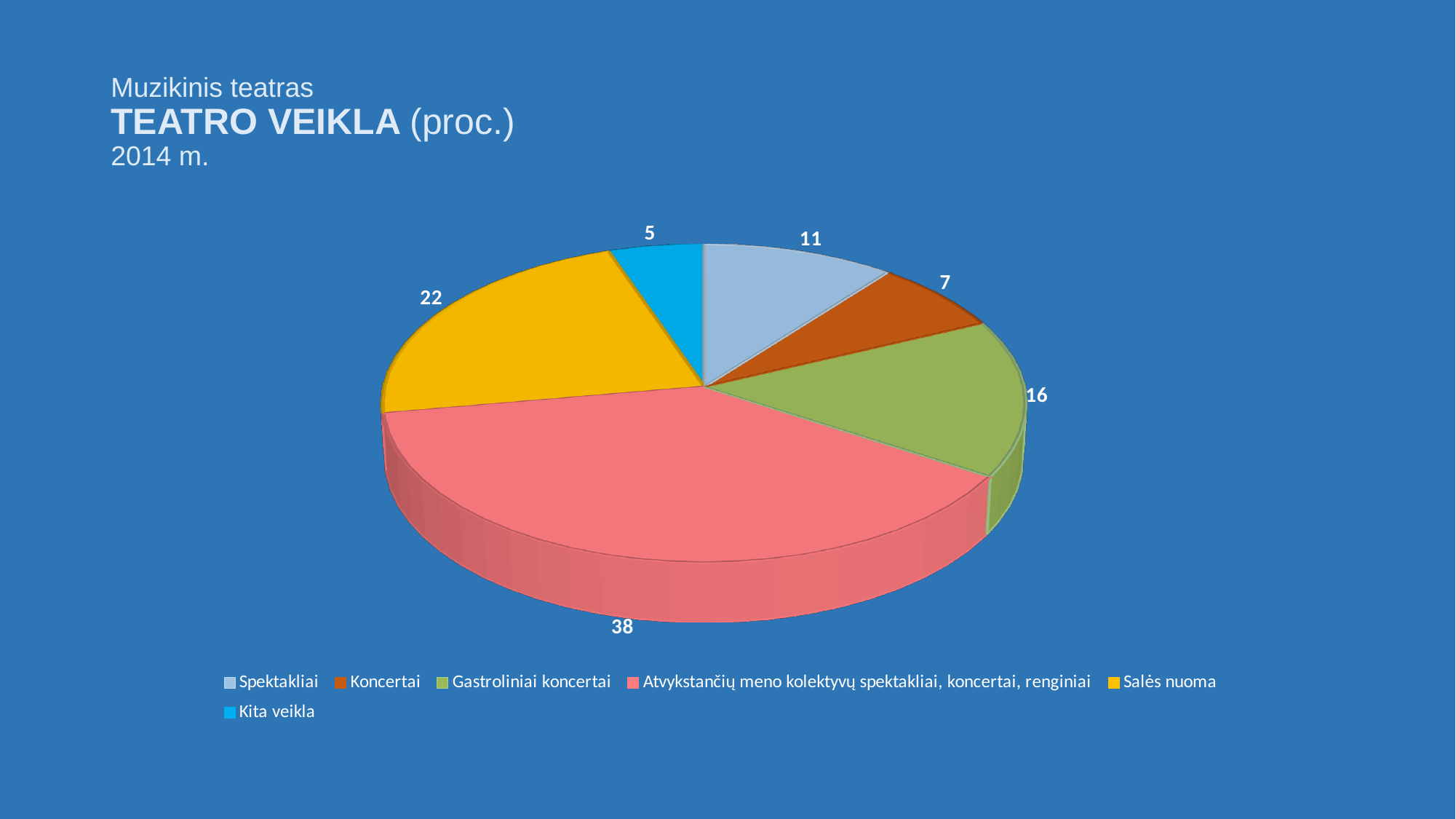
Which year does the chart title refer to? 2014 m. What type of chart is shown on the slide? pie chart What is the value for Salės nuoma? 22 What is the value for Kita veikla? 5 Which category has the smallest slice of the pie? Kita veikla What is the difference between the values for Salės nuoma and Gastroliniai koncertai? 6 What is the value for Spektakliai? 11 Which is larger, the value for Spektakliai or the value for Koncertai? Spektakliai How many categories does the pie chart have? 6 What is the value for Koncertai? 7 What is the value for Gastroliniai koncertai? 16 Which category has the largest slice of the pie? Atvykstančių meno kolektyvų spektakliai, koncertai, renginiai